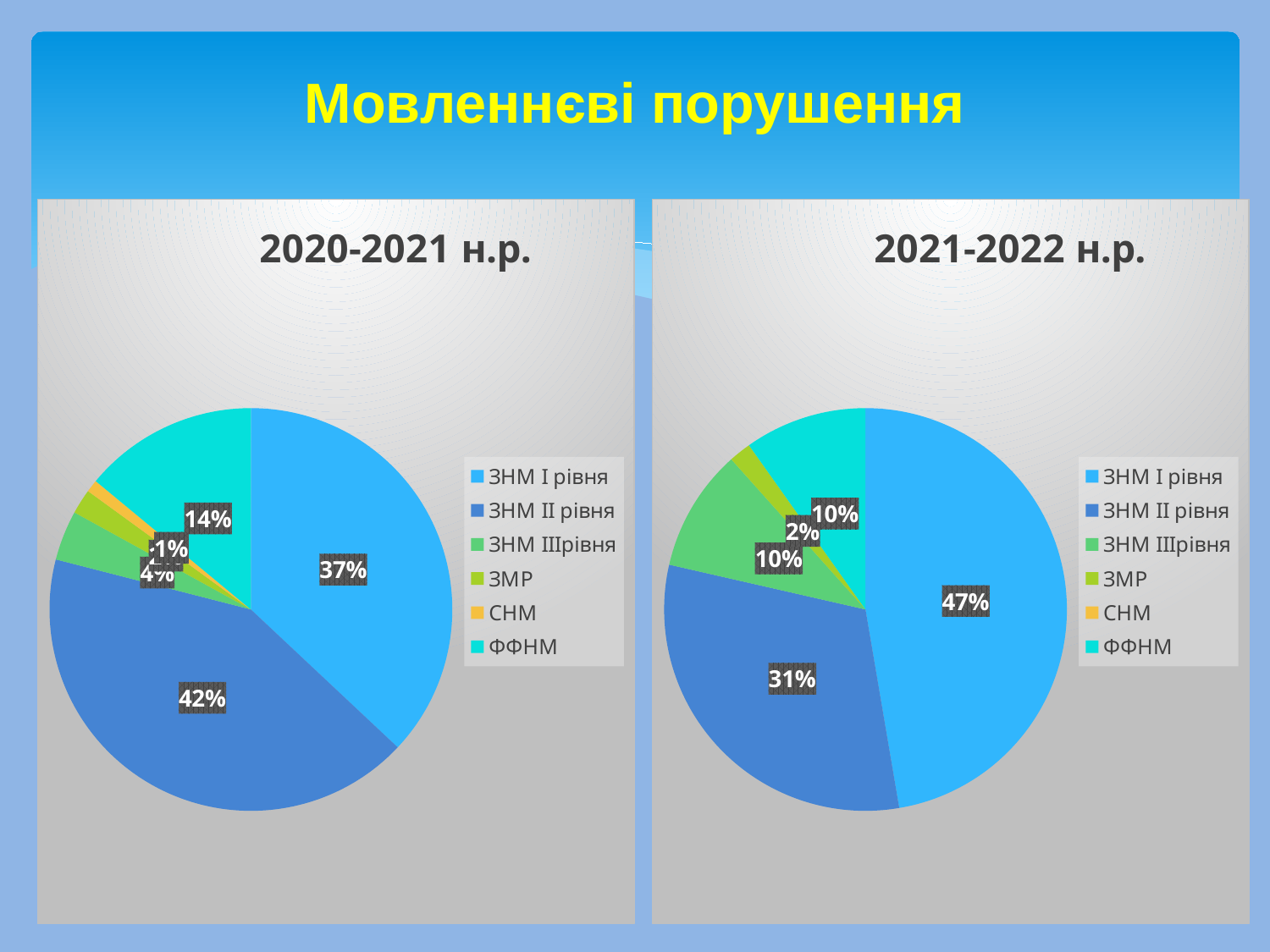
In the 2021-2022 н.р. chart, what is the difference between the shares of ЗНМ I рівня and ЗНМ II рівня? 16% What type of chart is the 2020-2021 н.р. chart? Pie chart In the 2020-2021 н.р. chart, what share does ЗНМ I рівня have? 37% In the 2020-2021 н.р. chart, what share does ФФНМ have? 14% In the 2020-2021 н.р. chart, which category has the largest slice? ЗНМ II рівня In the 2021-2022 н.р. chart, what share does ЗНМ IIIрівня have? 10% In the 2021-2022 н.р. chart, which category has the largest slice? ЗНМ I рівня In the 2021-2022 н.р. chart, what share does ЗНМ II рівня have? 31% In the 2021-2022 н.р. chart, what share does ЗНМ I рівня have? 47% How many entries does the legend of the 2021-2022 н.р. chart list? 6 Which is larger in the 2020-2021 н.р. chart: the share of ЗНМ I рівня or ЗНМ II рівня? ЗНМ II рівня In the 2020-2021 н.р. chart, what share does ЗНМ II рівня have? 42%